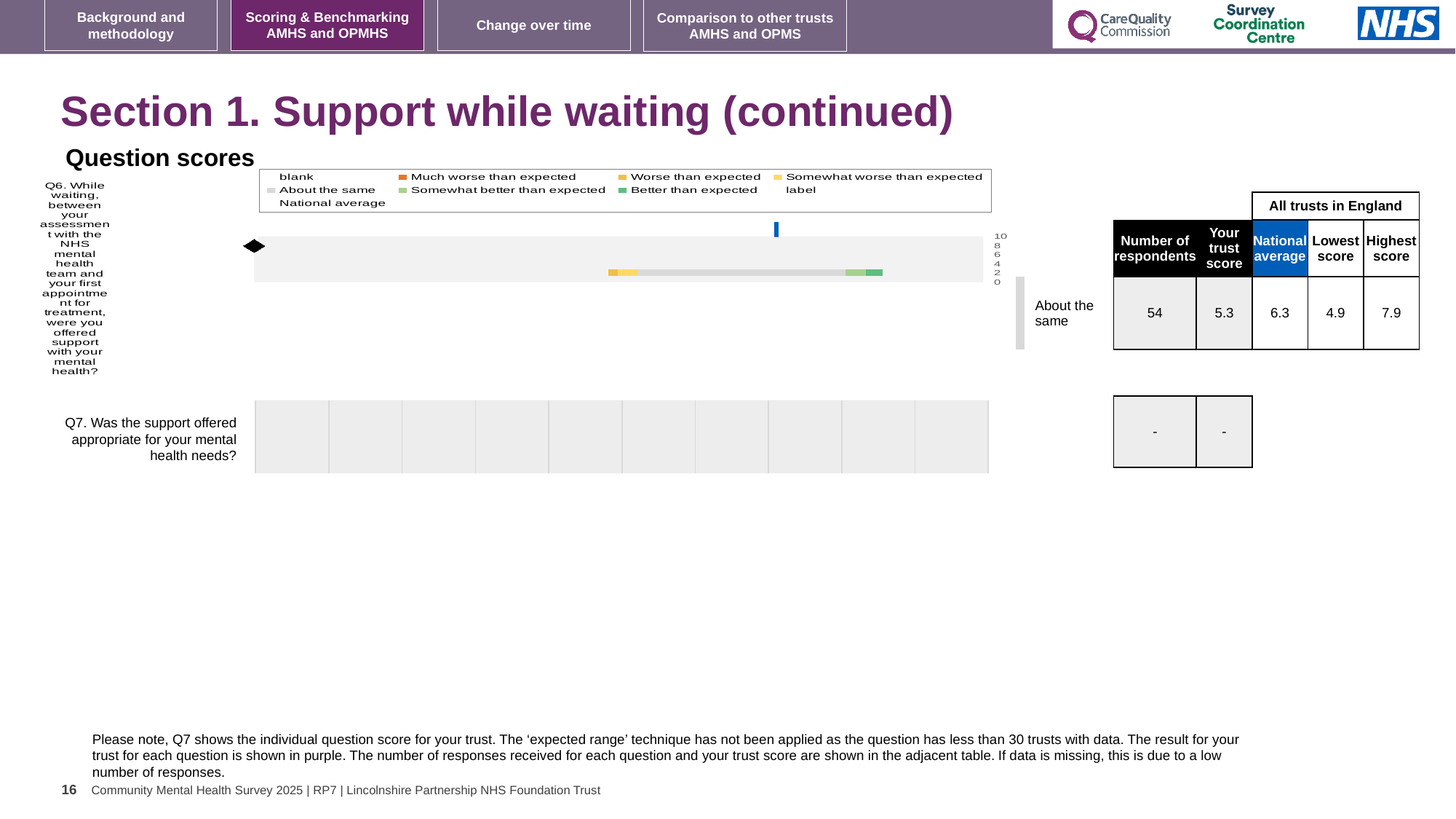
How many questions are plotted on the slide? 2 What category label is shown for the Q6 trust result? About the same What is the trust score for Q6 shown in the table next to the chart? 5.3 How many respondents answered Q6? 54 For Q6, which is larger: the trust score or the national average? national average What is the difference between the national average and the trust score for Q6? 1.0 Is the trust score for Q6 greater or less than 6? less What is the lowest score among all trusts in England for Q6? 4.9 What is the difference between the highest and lowest trust scores for Q6? 3.0 What is the national average score for Q6? 6.3 What kind of chart is used to show the Q6 question score? bar chart What is the highest score among all trusts in England for Q6? 7.9